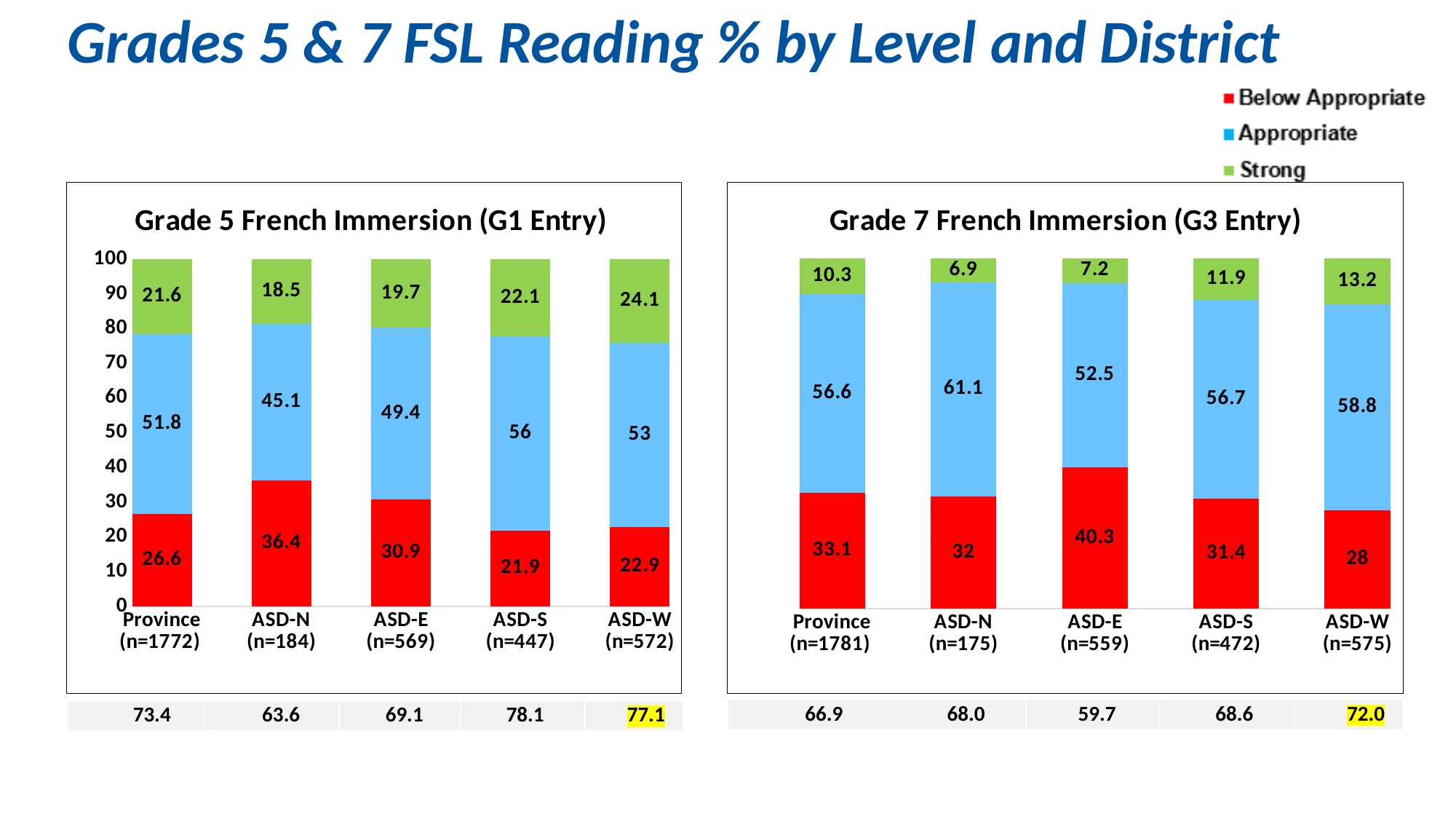
In the Grade 7 French Immersion (G3 Entry) chart, what is the Appropriate value for ASD-E? 52.5 In the Grade 7 French Immersion (G3 Entry) chart, which category has the lowest Strong value? ASD-N In the Grade 7 French Immersion (G3 Entry) chart, which category has the highest Below Appropriate value? ASD-E In the Grade 5 French Immersion (G1 Entry) chart, which district has the highest Strong value? ASD-W Which colour represents the Strong series in the legend? Green In the Grade 5 French Immersion (G1 Entry) chart, is the Appropriate value larger for ASD-S or ASD-E? ASD-S In the Grade 5 French Immersion (G1 Entry) chart, what is the Below Appropriate value for ASD-N? 36.4 In the Grade 7 French Immersion (G3 Entry) chart, what is the Strong value for ASD-W? 13.2 In the Grade 5 French Immersion (G1 Entry) chart, what is the difference between the Below Appropriate values for ASD-N and ASD-S? 14.5 What kind of chart is the Grade 5 French Immersion (G1 Entry) chart? Stacked bar chart How many categories are shown on the x axis of the Grade 7 French Immersion (G3 Entry) chart? 5 How many series does the legend list? 3